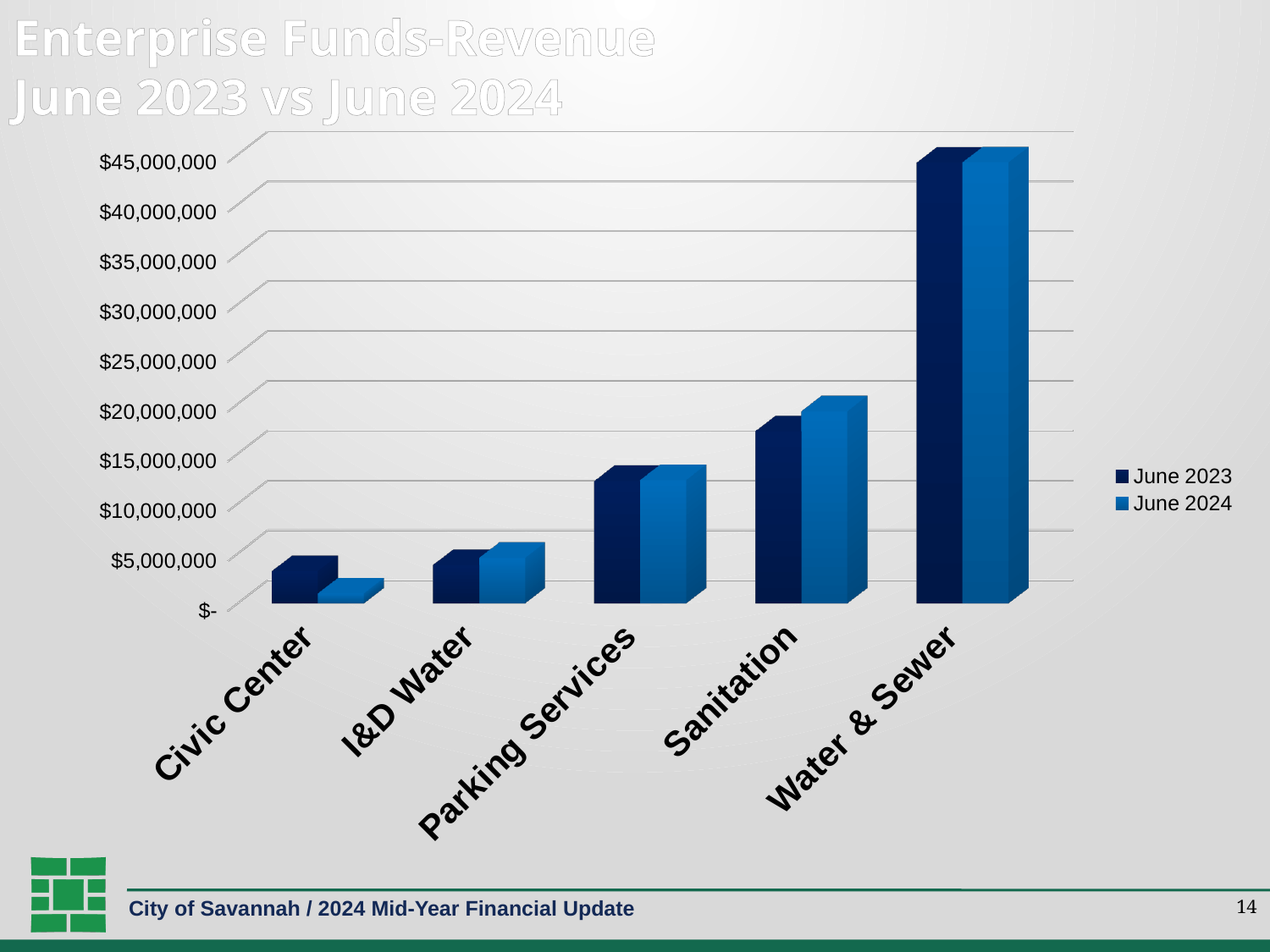
How many categories are shown on the x axis of the chart? 5 What kind of chart is shown on the slide? Bar chart Is the value for Parking Services in June 2023 greater or less than $15,000,000? less Which category has the lowest revenue in June 2024? Civic Center For Sanitation, which is larger: June 2023 or June 2024? June 2024 For Civic Center, which is larger: June 2023 or June 2024? June 2023 Which category has the highest revenue in June 2024? Water & Sewer What is the title of the chart on the slide? Enterprise Funds-Revenue June 2023 vs June 2024 Is the value for Water & Sewer in June 2023 greater or less than $40,000,000? greater Is the value for Civic Center in June 2024 greater or less than $5,000,000? less How many series does the legend list? 2